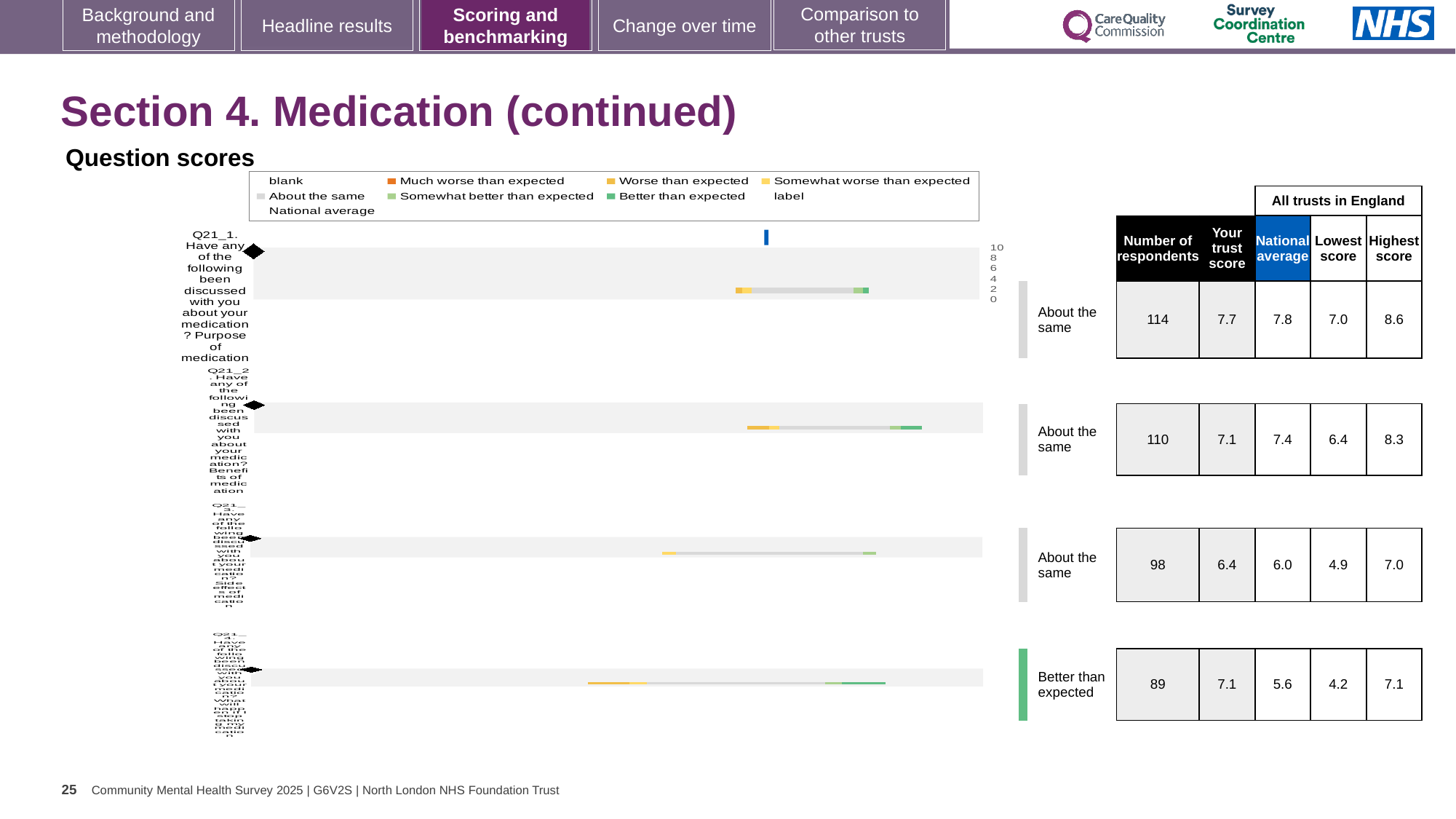
What is the difference between your trust score and the national average for Q21_4 in the table next to the chart? 1.5 In the table next to the chart, what is the national average for Q21_2 (Benefits of medication)? 7.4 In the table next to the chart, what is the number of respondents for Q21_1 (Purpose of medication)? 114 How many questions (bars) are plotted in the question scores chart? 4 In the table next to the chart, what is the lowest score for the fourth question, Q21_4? 4.2 How many entries does the legend of the question scores chart list? 9 Which question row in the chart is rated 'Better than expected'? Q21_4 Which question has the highest number of respondents in the table next to the chart? Q21_1 In the table next to the chart, what is your trust score for Q21_1 (Purpose of medication)? 7.7 In the table next to the chart, what is the highest score for Q21_3 (Side effects of medication)? 7.0 For Q21_3, which is larger in the table next to the chart: your trust score or the national average? Your trust score What kind of chart is used to show the question scores on this slide? bar chart